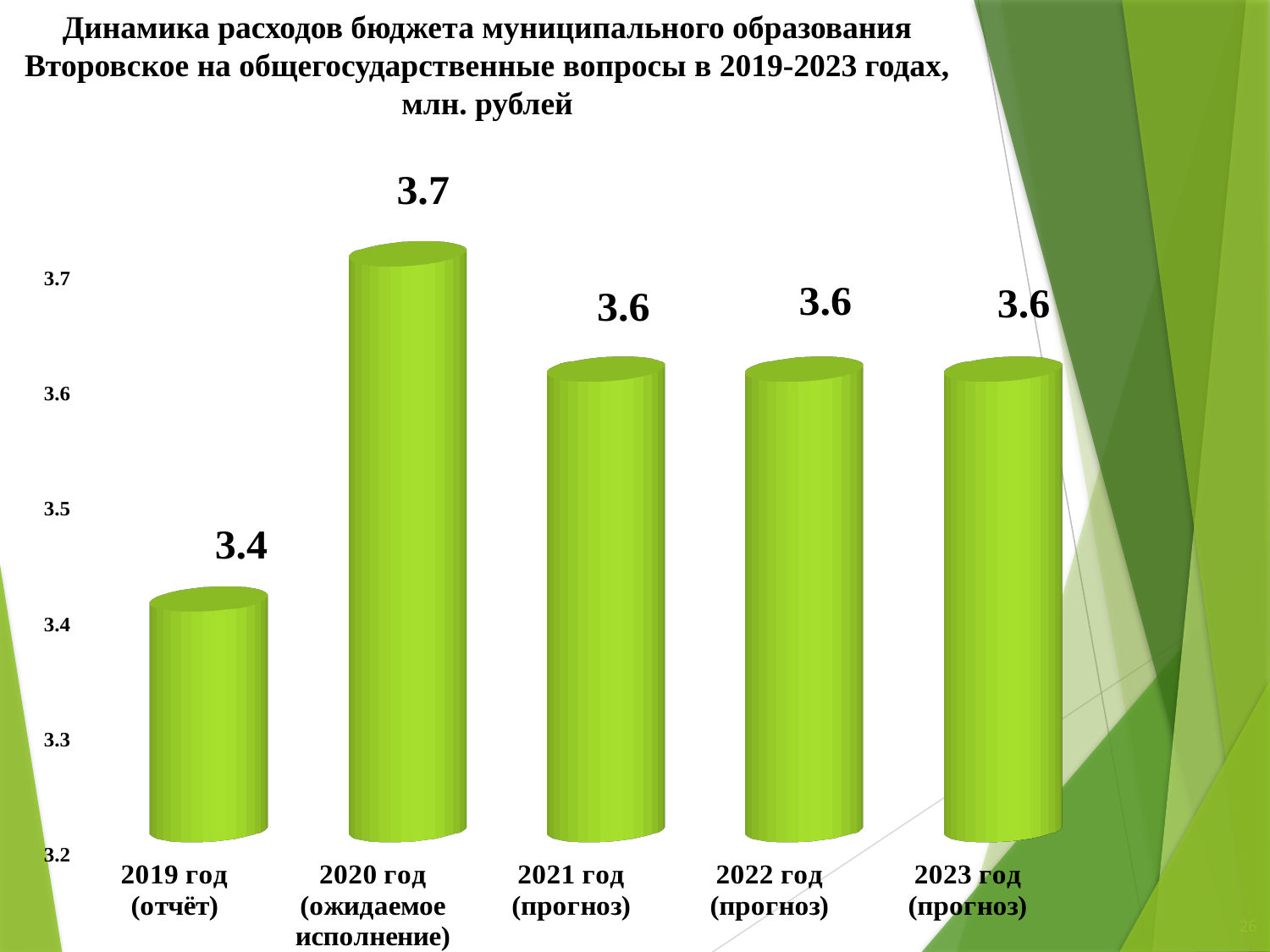
Which is larger, the value for 2019 год or the value for 2022 год? 2022 год What is the value for 2019 год (отчёт)? 3.4 What is the value for 2020 год (ожидаемое исполнение)? 3.7 Do the values rise or fall from 2019 год to 2020 год? rise What is the difference between the values for 2020 год and 2021 год? 0.1 What is the difference between the values for 2020 год and 2019 год? 0.3 Which year has the lowest value? 2019 год (отчёт) What unit of measurement is stated in the chart title? млн. рублей What is the value for 2023 год (прогноз)? 3.6 What kind of chart is shown on the slide? bar chart How many years (categories) are shown in the chart? 5 Which year has the highest value? 2020 год (ожидаемое исполнение)